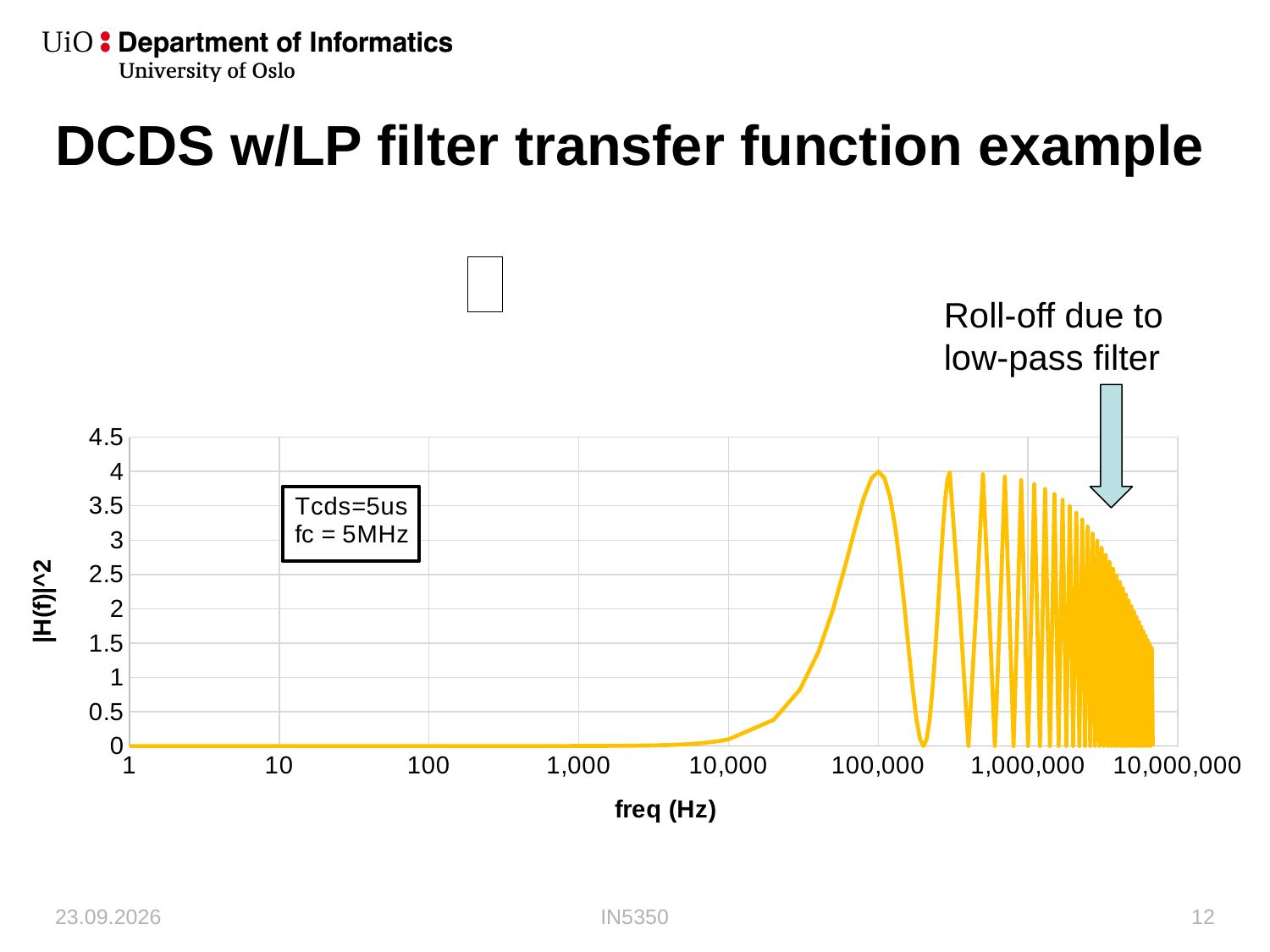
Is the value of |H(f)|^2 at 10,000 Hz greater or less than 0.5? less Is the value of |H(f)|^2 at 100,000 Hz greater or less than 3.5? greater Is the value of |H(f)|^2 at 10 Hz greater or less than 1? less Does the peak envelope of the curve rise or fall as frequency increases from 1,000,000 Hz to 10,000,000 Hz? fall What kind of chart is shown on the slide? line chart Does the curve rise or fall as frequency increases from 10,000 Hz to 100,000 Hz? rise What is the highest value shown on the y axis? 4.5 What is the label of the x axis? freq (Hz)